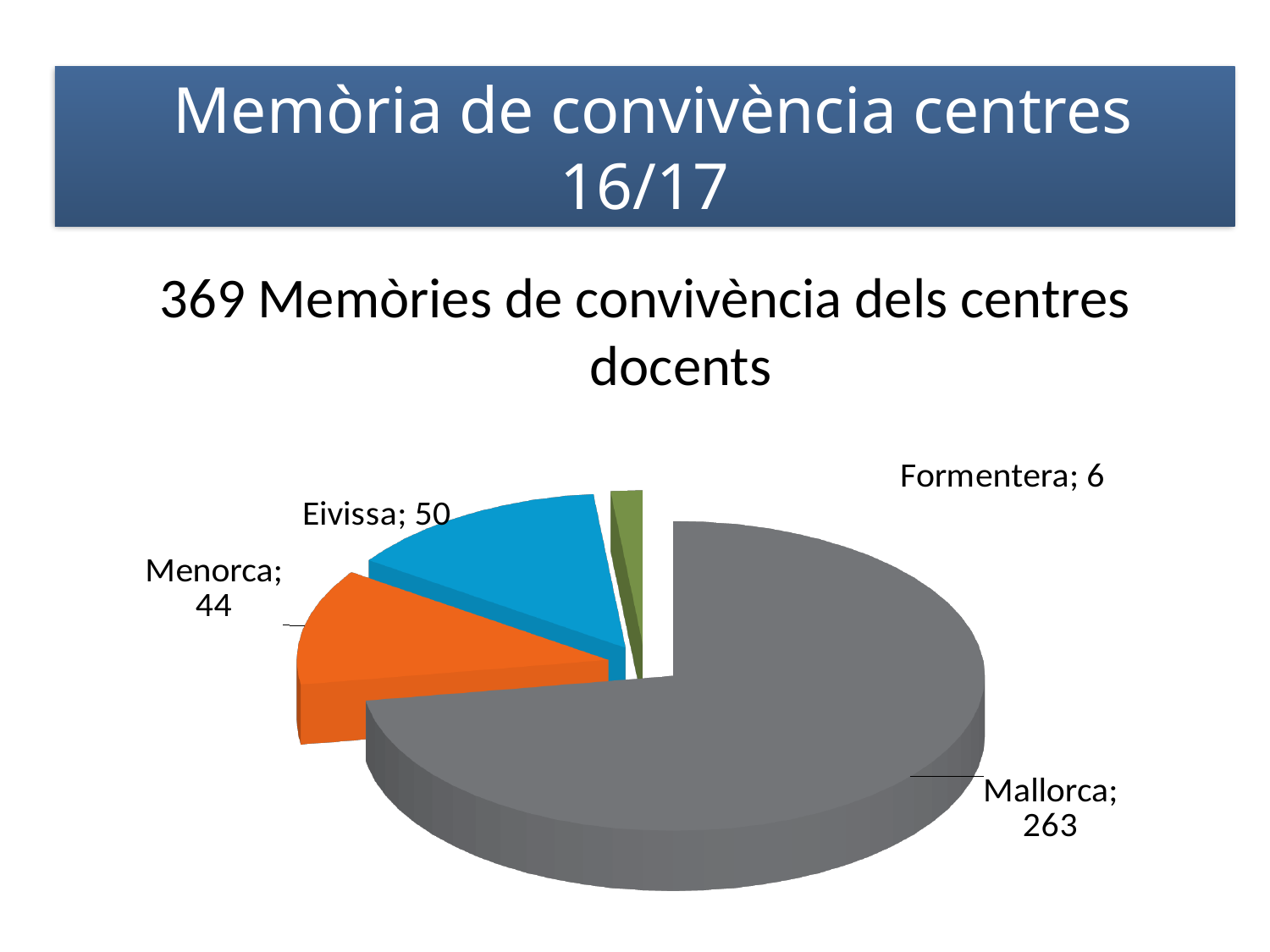
What is the difference between the values for Mallorca and Eivissa? 213 What kind of chart is shown on the slide? Pie chart How many slices does the pie chart have? 4 What is the value for Formentera in the pie chart? 6 What is the value for Menorca in the pie chart? 44 Which island has the largest slice in the pie chart? Mallorca What is the difference between the values for Eivissa and Menorca? 6 What is the value for Mallorca in the pie chart? 263 What is the value for Eivissa in the pie chart? 50 Which is larger, the value for Eivissa or the value for Menorca? Eivissa What colour is the Menorca slice in the pie chart? Orange Which island has the smallest slice in the pie chart? Formentera